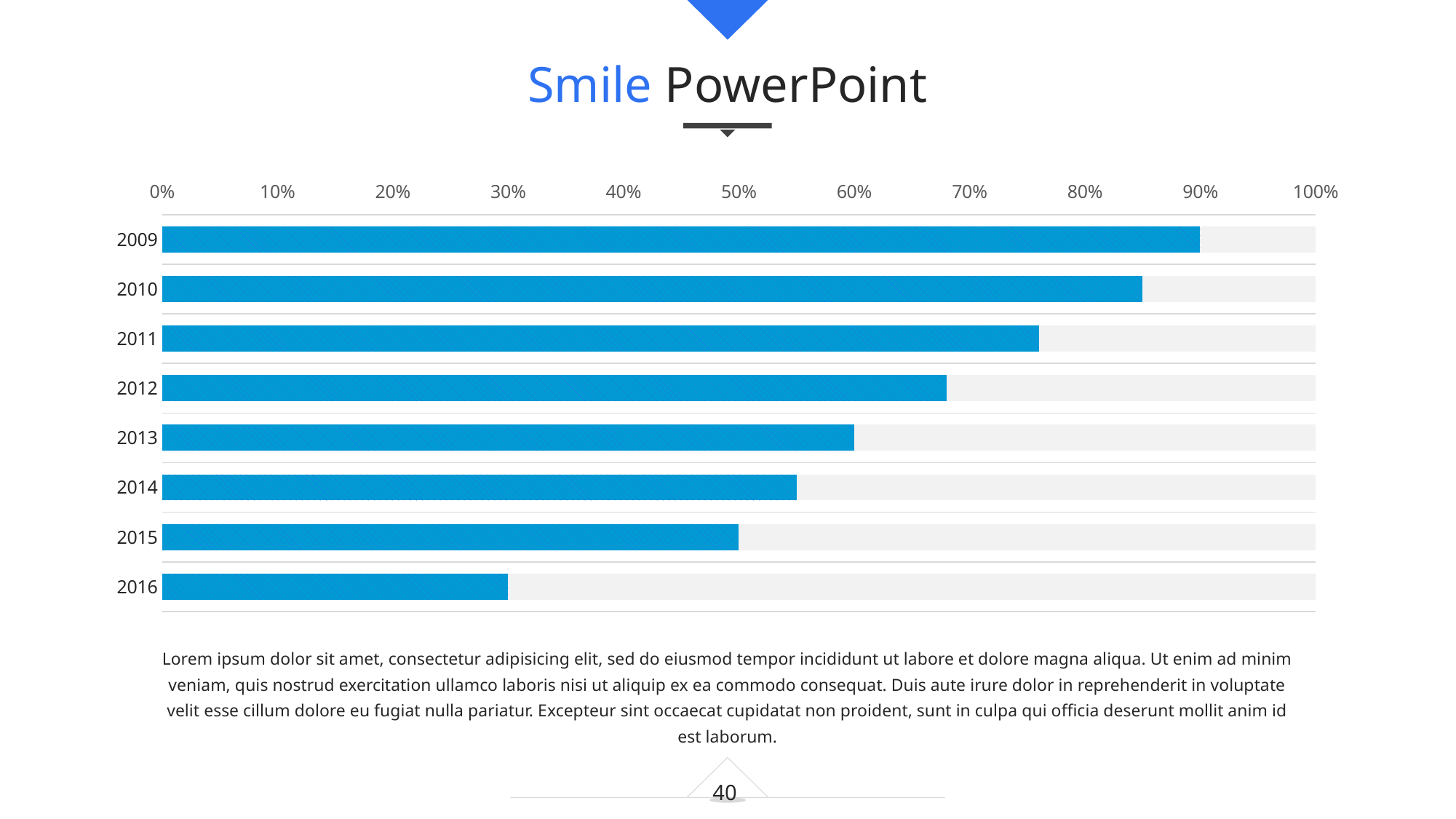
What is the value for 2016? 30% Which is larger, the value for 2011 or the value for 2014? 2011 How many years are plotted in the chart? 8 Which year has the lowest value in the chart? 2016 What is the first year listed on the vertical axis of the chart? 2009 Is the value for 2012 greater or less than 70%? less Is the value for 2010 greater or less than 80%? greater Is the value for 2011 greater or less than 70%? greater Which year has the highest value in the chart? 2009 Do the values rise or fall from 2009 to 2016? fall What kind of chart is shown on the slide? bar chart